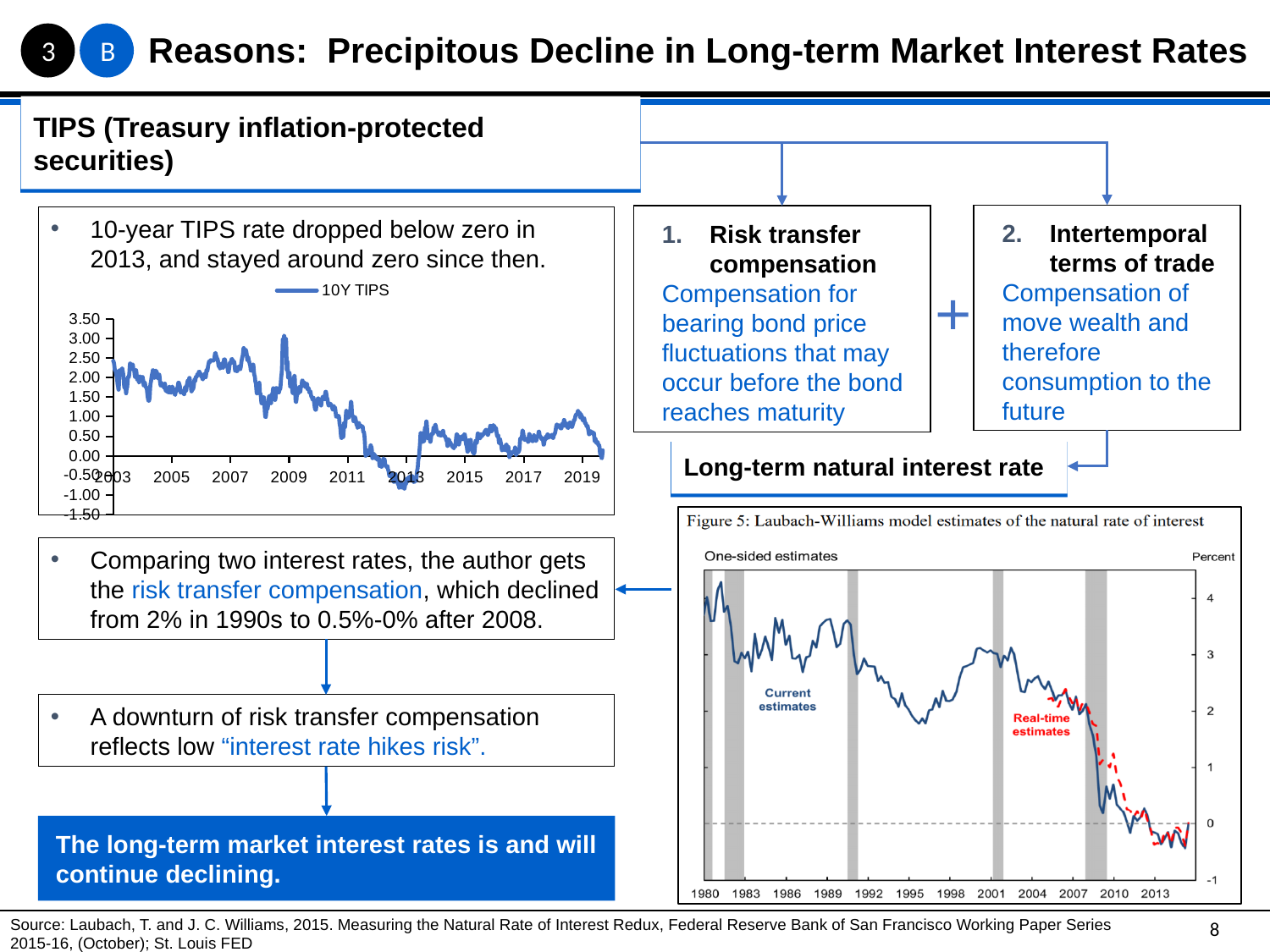
Overall, does the 10Y TIPS rate rise or fall from 2003 to 2019? fall In the Figure 5 chart, how many series are plotted? 2 In the Figure 5 chart, is the value of the current estimates in 2013 greater or less than 1 percent? less In the 10Y TIPS chart, is the value at the start of 2003 greater or less than 2.00? greater In the 10Y TIPS chart, is the peak value around 2009 greater or less than 2.50? greater What kind of chart is the 10Y TIPS chart on the left of the slide? line chart How many series does the legend of the 10Y TIPS chart list? 1 Overall, do the current estimates in the Figure 5 chart rise or fall from 1980 to 2013? fall What is the title of the chart on the right of the slide? Figure 5: Laubach-Williams model estimates of the natural rate of interest What is the name of the series shown in the legend of the chart on the left? 10Y TIPS